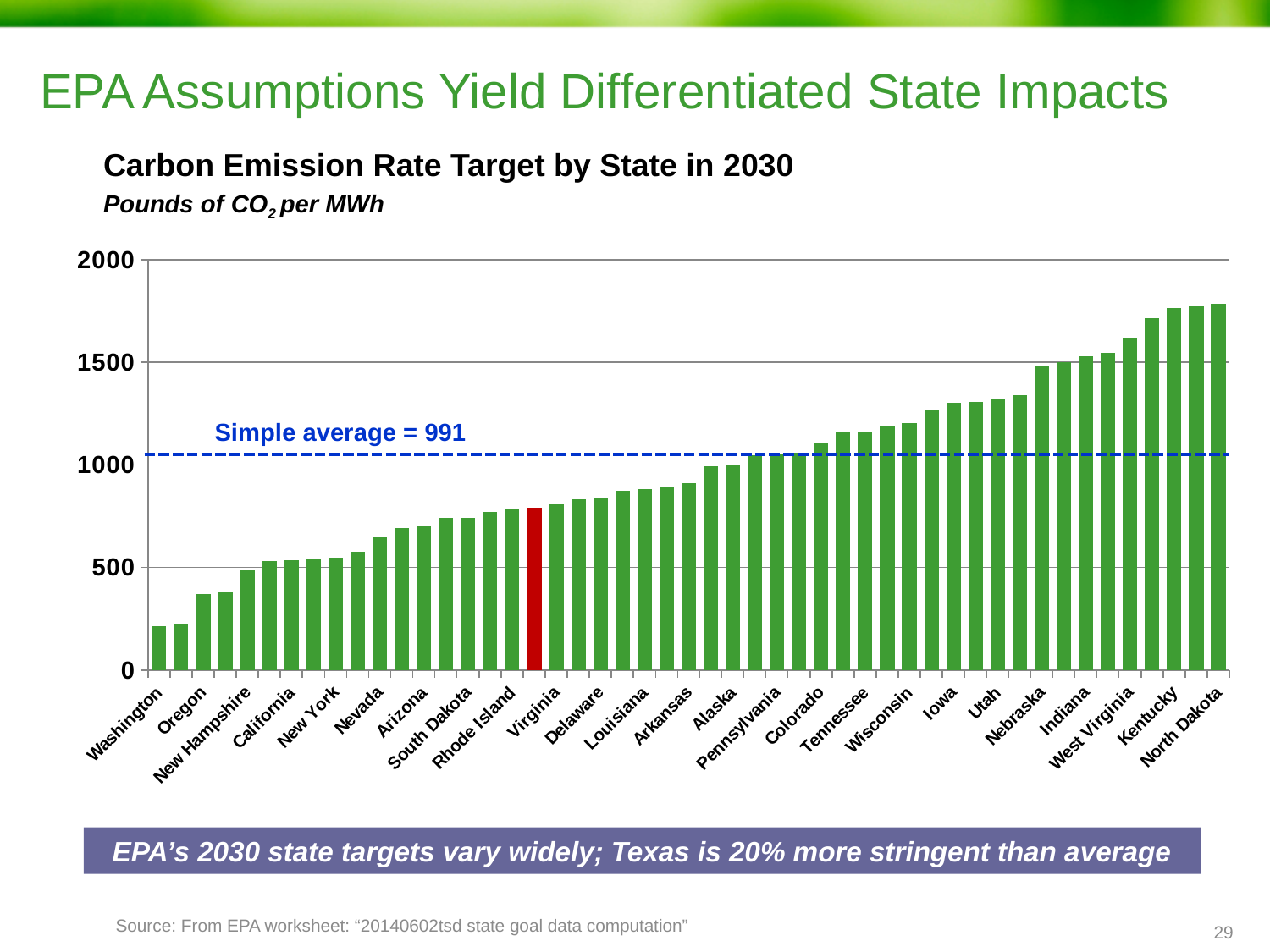
What is the title of the chart? Carbon Emission Rate Target by State in 2030 Which state has the lowest carbon emission rate target in 2030? Washington Is the value for Iowa greater or less than 1000? greater Is the value for Washington greater or less than 500? less What is the simple average carbon emission rate target shown on the chart? 991 What kind of chart is shown on the slide? bar chart Is the value for Kentucky greater or less than 1500? greater Which state has the highest carbon emission rate target in 2030? North Dakota Do the bar values rise or fall from left to right along the x axis? rise Which has a higher target, Kentucky or Virginia? Kentucky Which has a higher target, Washington or Oregon? Oregon